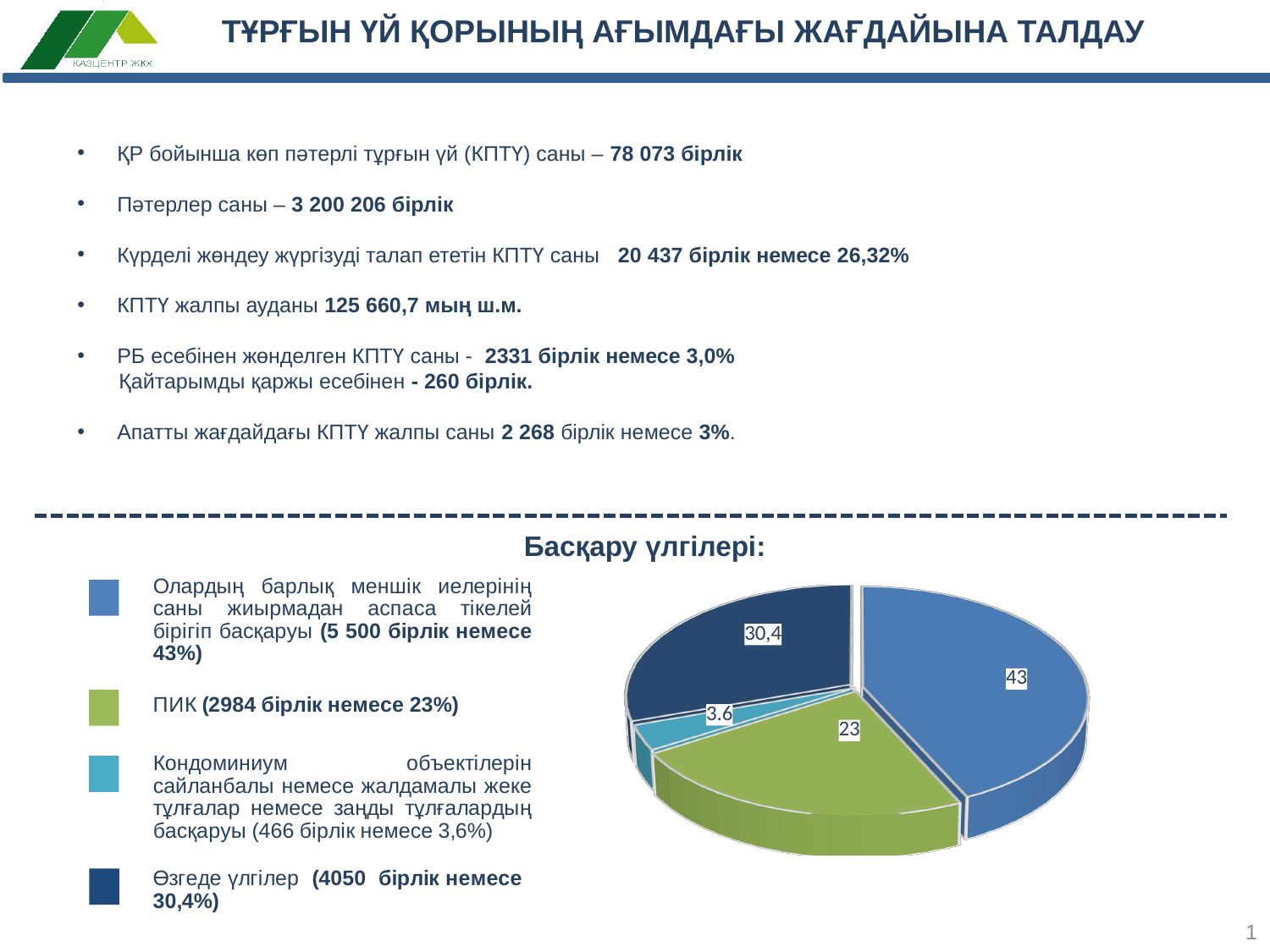
What is the data label on the largest slice of the pie chart? 43 What share of the pie does the ПИК slice represent? 23% Is the value of the largest slice in the pie chart greater or less than 40? greater What value is shown on the dark blue slice of the pie chart (Өзгеде үлгілер)? 30,4 What kind of chart is shown under the heading "Басқару үлгілері"? pie chart What is the difference between the largest slice (43) and the ПИК slice (23) in the pie chart? 20 What value is shown on the green slice of the pie chart (ПИК)? 23 What is the data label on the smallest slice of the pie chart? 3.6 How many slices does the pie chart have? 4 What is the title above the pie chart? Басқару үлгілері Which slice is larger in the pie chart: the dark blue one labelled 30,4 or the green one labelled 23? the dark blue one (30,4) What colour is the ПИК slice in the pie chart? green